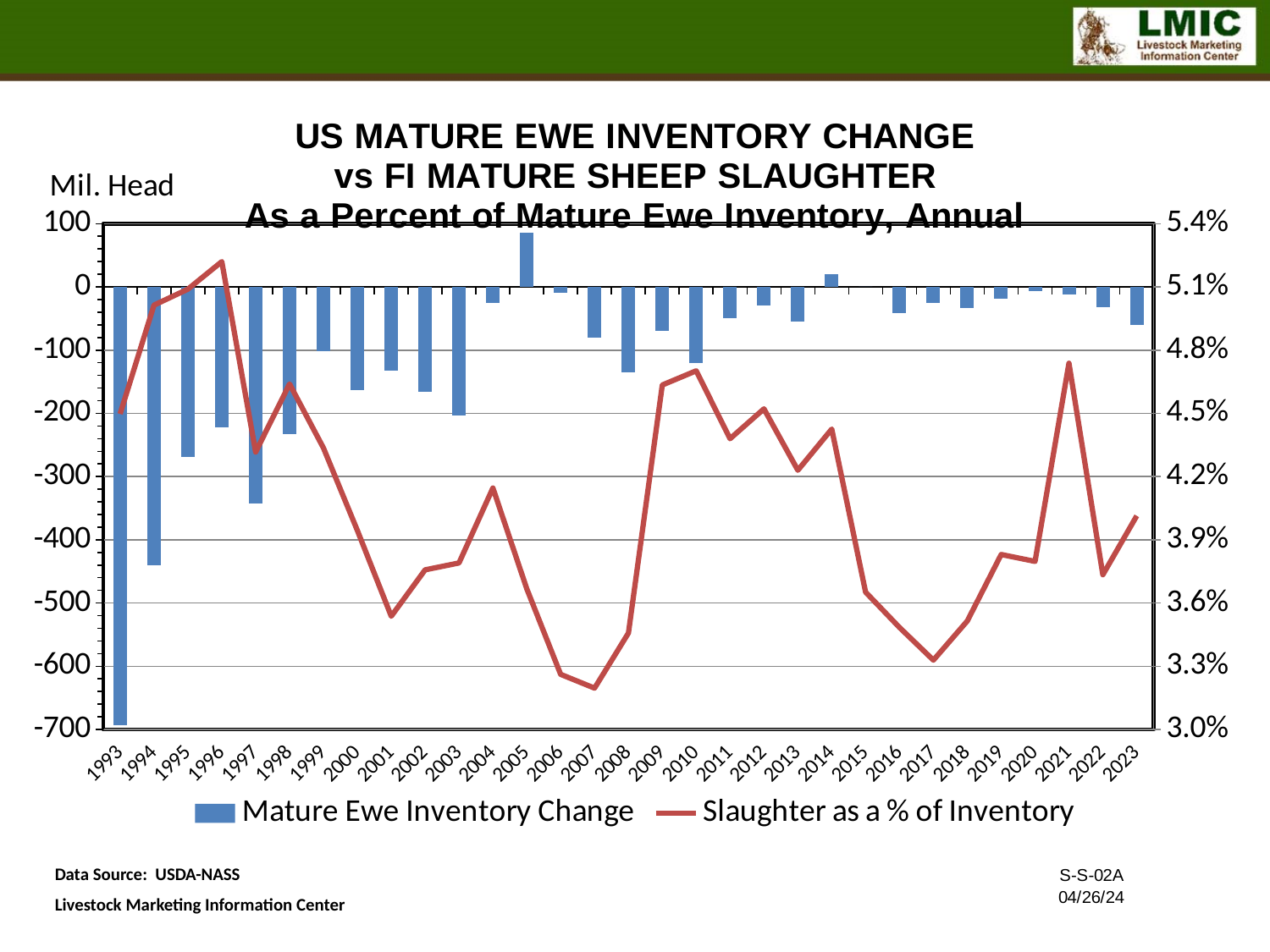
How many series does the legend list? 2 Is the Slaughter as a % of Inventory value for 2021 greater or less than 4.5%? greater How many years are shown along the x axis? 31 Does the Slaughter as a % of Inventory line rise or fall from 1996 to 2001? fall What kind of chart is shown on the slide? A combination bar and line chart In which year does the Slaughter as a % of Inventory line reach its highest point? 1996 Which year has the larger Slaughter as a % of Inventory value, 2008 or 2009? 2009 Is the Mature Ewe Inventory Change for 1993 greater or less than -600? less Which year has the lowest (most negative) Mature Ewe Inventory Change bar? 1993 Is the Slaughter as a % of Inventory value for 2017 greater or less than 3.6%? less Which year has the highest Mature Ewe Inventory Change bar? 2005 In which year does the Slaughter as a % of Inventory line reach its lowest point? 2007